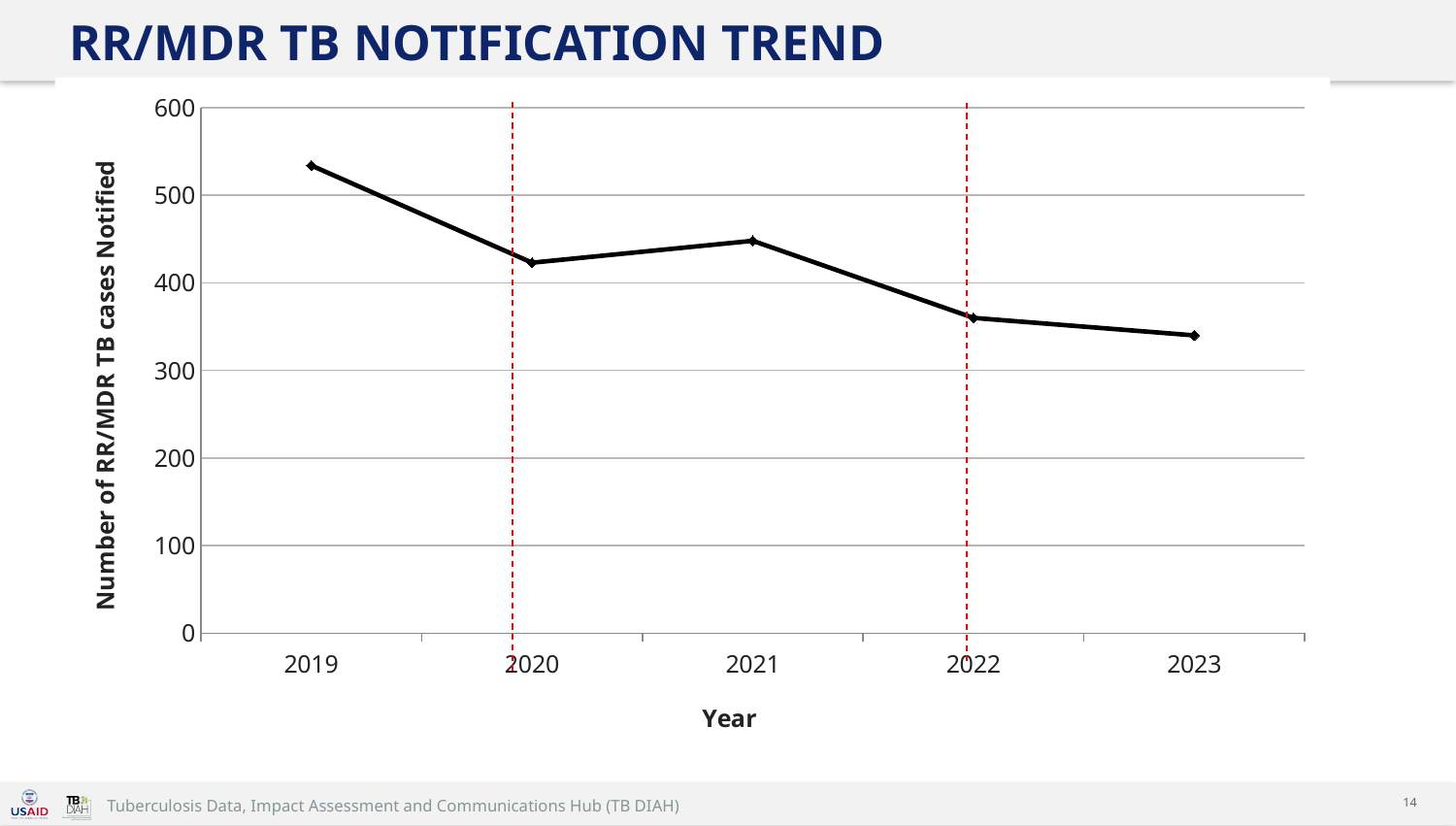
What is the label of the y-axis? Number of RR/MDR TB cases Notified How many years are plotted on the x-axis? 5 What type of chart is shown on the slide? line chart Is the value for 2019 greater or less than 500? greater Which year has a higher number of cases notified, 2020 or 2021? 2021 Is the value for 2023 greater or less than 300? greater Is the value for 2022 greater or less than 400? less Which year has the lowest number of RR/MDR TB cases notified? 2023 What is the title of the chart? RR/MDR TB NOTIFICATION TREND Which year has the highest number of RR/MDR TB cases notified? 2019